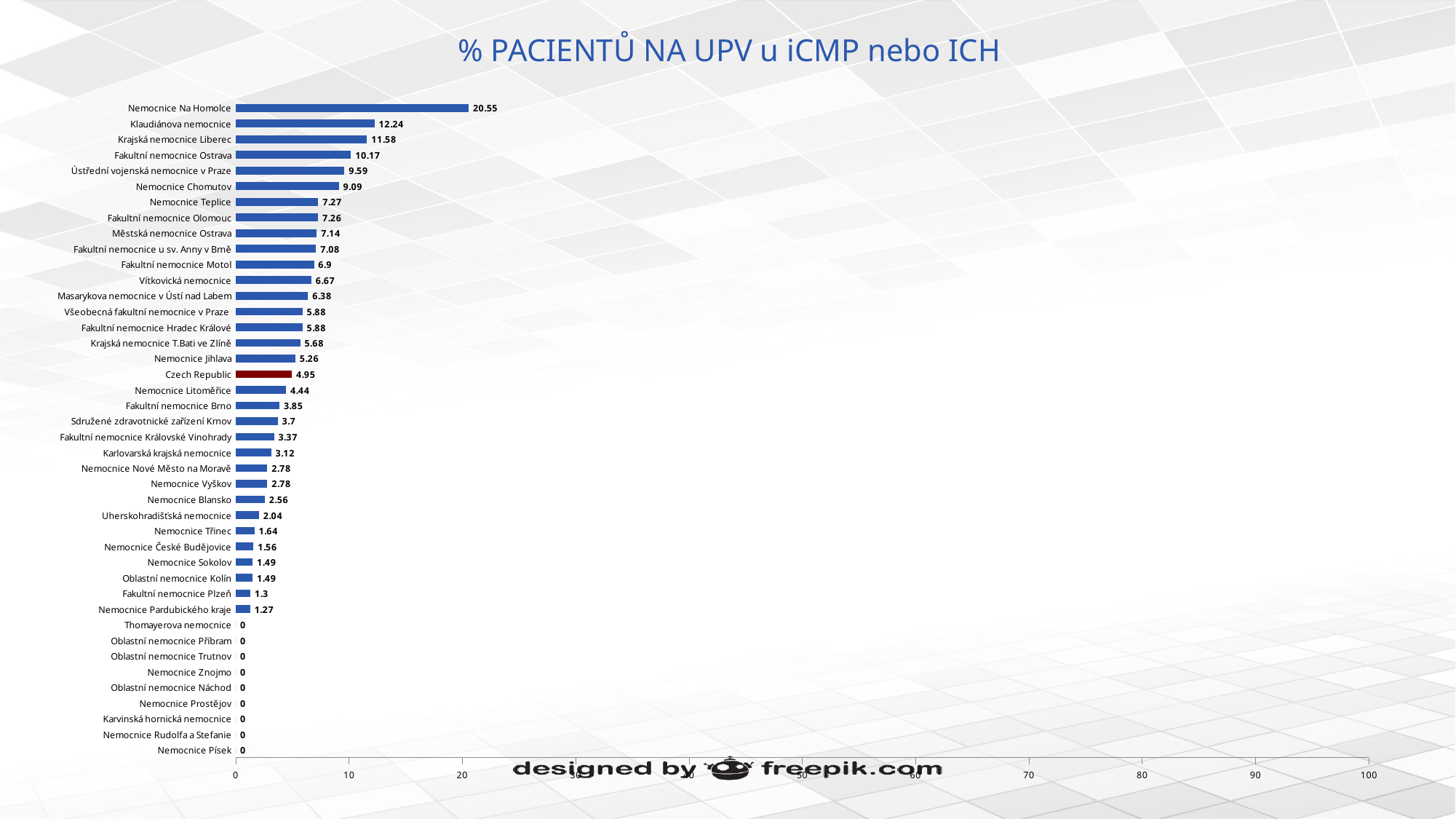
Is the value for Krajská nemocnice Liberec greater or less than 10? greater What kind of chart is shown on the slide? bar chart What is the value for Czech Republic? 4.95 Which category's bar is drawn in a different colour (dark red) from the others? Czech Republic What is the value for Nemocnice Na Homolce? 20.55 How many hospitals have a value of 0? 9 How many categories are shown on the chart? 42 What is the value for Fakultní nemocnice Motol? 6.9 What is the difference between the values for Nemocnice Jihlava and Czech Republic? 0.31 Which hospital has the highest value? Nemocnice Na Homolce Which is larger, the value for Fakultní nemocnice Ostrava or the value for Nemocnice Chomutov? Fakultní nemocnice Ostrava What is the difference between the values for Nemocnice Na Homolce and Klaudiánova nemocnice? 8.31